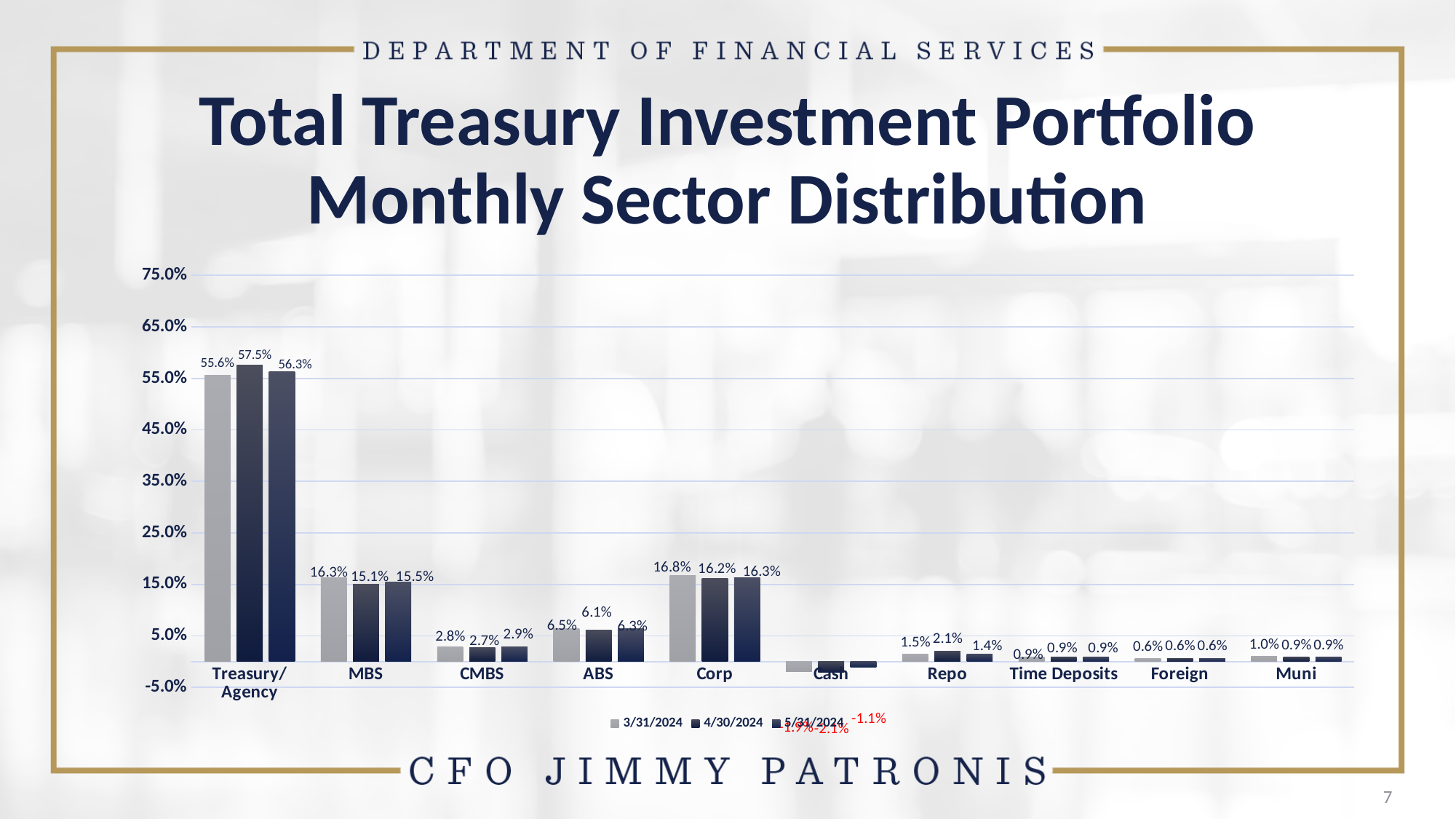
What is the title of the chart? Total Treasury Investment Portfolio Monthly Sector Distribution What is the difference between the Treasury/Agency values for 4/30/2024 and 3/31/2024? 1.9% What is the value for MBS for 3/31/2024? 16.3% What is the value for Treasury/Agency for 4/30/2024? 57.5% What kind of chart is shown on the slide? bar chart Is the value for Treasury/Agency for 3/31/2024 greater or less than 45.0%? greater What is the value for Repo for 4/30/2024? 2.1% Which is larger for 3/31/2024: Corp or MBS? Corp How many series does the legend list? 3 What is the value for ABS for 5/31/2024? 6.3% How many sector categories are shown on the x axis? 10 Which sector has the highest value for 5/31/2024? Treasury/Agency